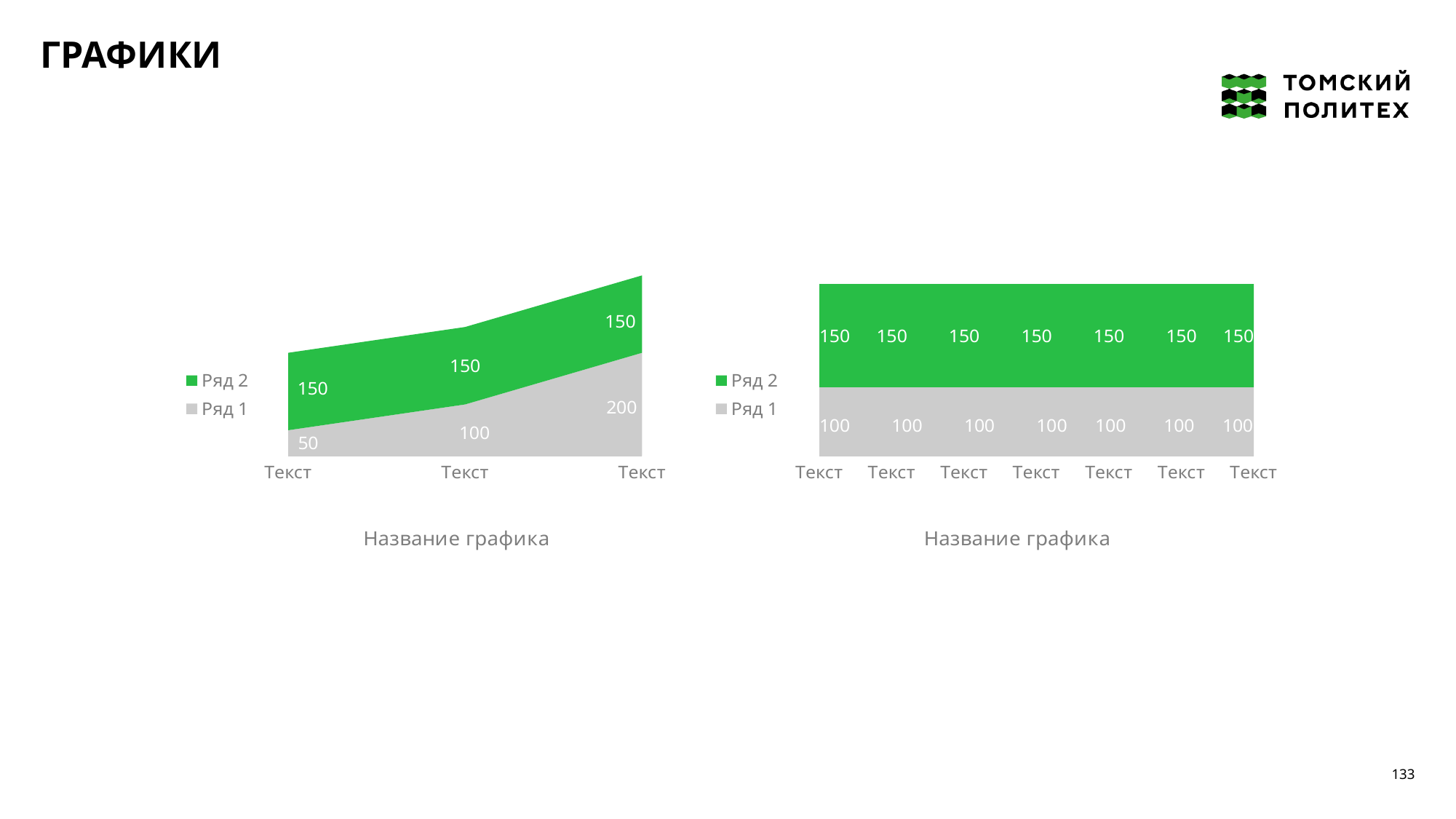
In the left chart, what is the value of Ряд 1 at the third (rightmost) category? 200 How many categories are plotted along the x axis of the right chart? 7 In the left chart, do the values of Ряд 1 rise or fall from left to right along the x axis? rise In the right chart, what is the value of Ряд 1 at the last (rightmost) category? 100 In the left chart, what is the value of Ряд 1 at the first (leftmost) category? 50 In the right chart, what is the stacked total of Ряд 1 and Ряд 2 at the first category? 250 How many series does the legend of the left chart list? 2 In the left chart, what is the difference between the Ряд 1 values at the rightmost and leftmost categories? 150 How many categories are plotted along the x axis of the left chart? 3 What kind of chart is the right chart on the slide? stacked area chart What kind of chart is the left chart on the slide? stacked area chart In the left chart, what is the value of Ряд 2 at the second (middle) category? 150